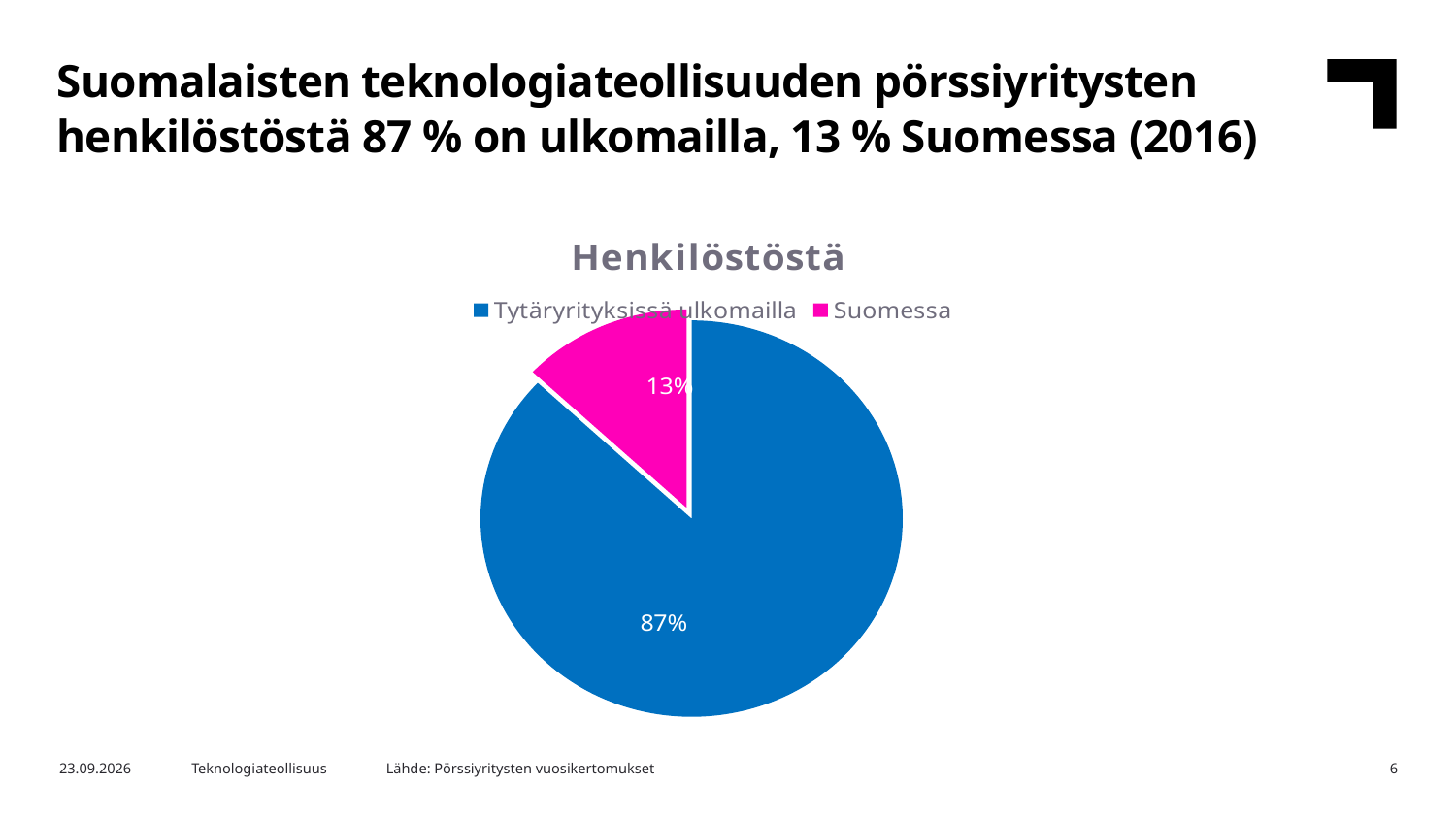
What share of the pie does the Tytäryrityksissä ulkomailla slice represent? 87% How many entries does the legend list? 2 What share of the pie does the Suomessa slice represent? 13% What is the title of the chart? Henkilöstöstä Which is larger, the Suomessa slice or the Tytäryrityksissä ulkomailla slice? Tytäryrityksissä ulkomailla What colour is the Suomessa slice in the pie chart? Magenta (pink) Which category has the largest share of the pie? Tytäryrityksissä ulkomailla How many slices does the pie chart have? 2 What is the difference in percentage points between the Tytäryrityksissä ulkomailla slice and the Suomessa slice? 74 percentage points Which category has the smallest share of the pie? Suomessa What kind of chart is shown on the slide? Pie chart